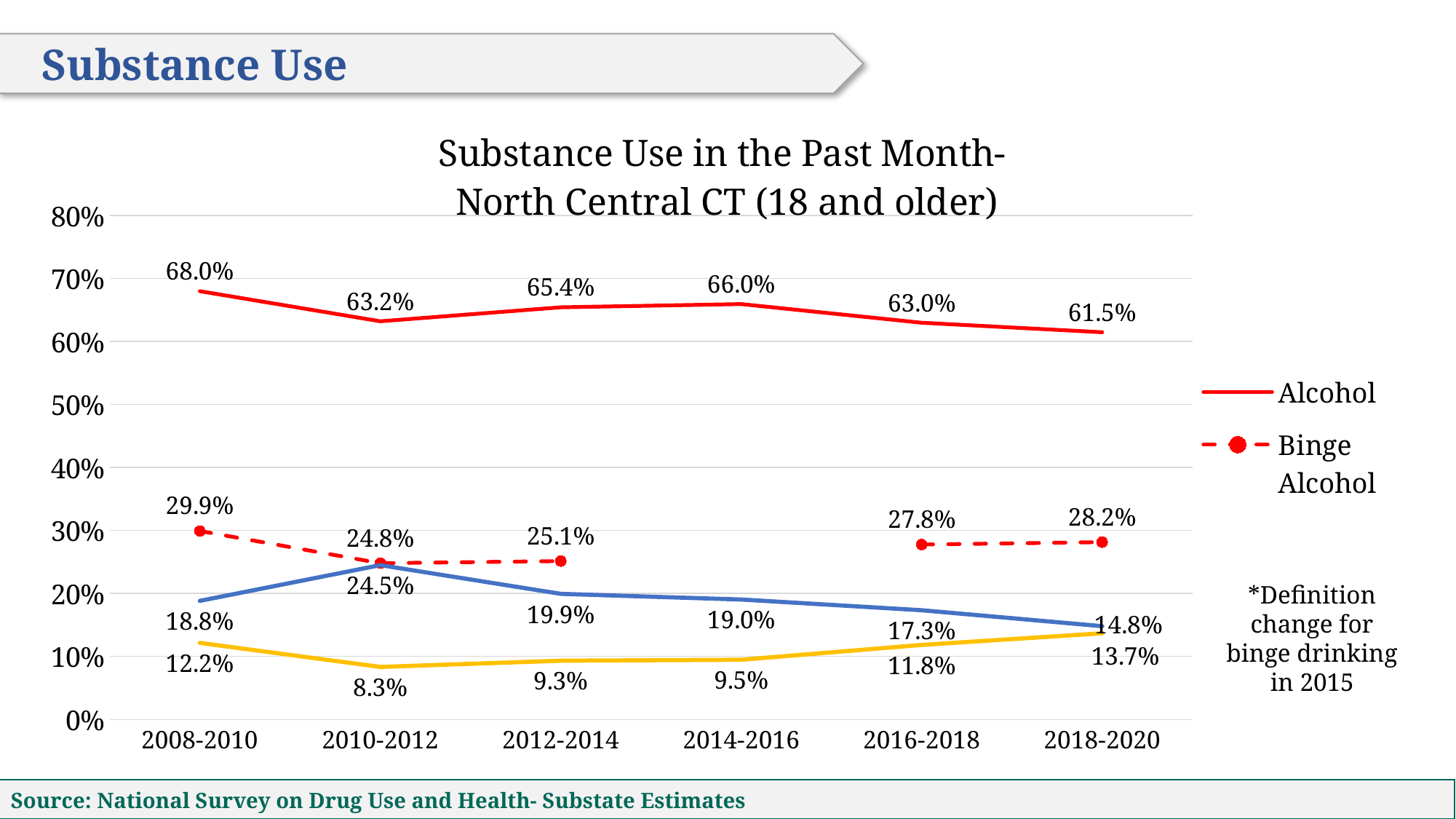
Does the Alcohol value rise or fall from 2014-2016 to 2018-2020? fall In which period is the Alcohol value highest? 2008-2010 Which is larger, the Binge Alcohol value for 2008-2010 or for 2018-2020? 2008-2010 Is the Alcohol value for 2014-2016 greater or less than 60%? greater What is the Alcohol value for 2018-2020? 61.5% How many series does the legend list? 2 What is the difference between the Alcohol values for 2008-2010 and 2018-2020? 6.5 percentage points What is the Binge Alcohol value for 2016-2018? 27.8% In which period is the Alcohol value lowest? 2018-2020 What is the Alcohol value for 2008-2010? 68.0% How many time periods are shown on the x axis? 6 What kind of chart is shown on the slide? line chart